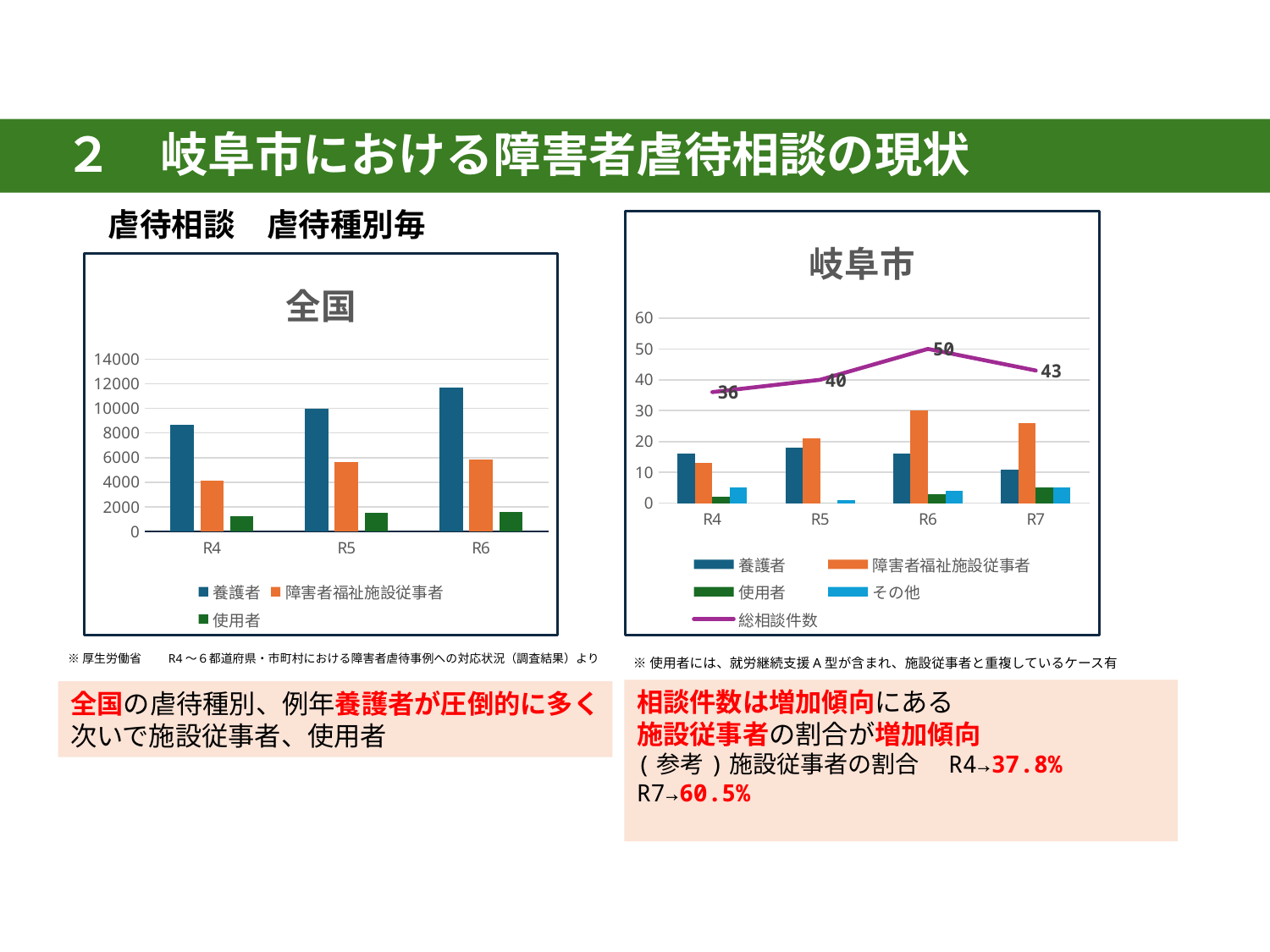
In the 岐阜市 chart, how many years are shown on the x axis? 4 In the 岐阜市 chart, which year has the highest 総相談件数? R6 What kind of chart is the 全国 chart? bar chart In the 岐阜市 chart, what is the difference in 総相談件数 between R6 and R4? 14 In the 全国 chart, is the value for 養護者 in R6 greater or less than 10000? greater In the 岐阜市 chart, is 総相談件数 for R7 greater or less than 40? greater In the 岐阜市 chart, what is the value of 総相談件数 for R6? 50 In the 全国 chart, does the value for 養護者 rise or fall from R4 to R6? rise In the 岐阜市 chart, which year has the lowest 総相談件数? R4 In the 岐阜市 chart, what is the value of 総相談件数 for R4? 36 In the 岐阜市 chart, how many series does the legend list? 5 In the 全国 chart, which series has the highest value in every year? 養護者